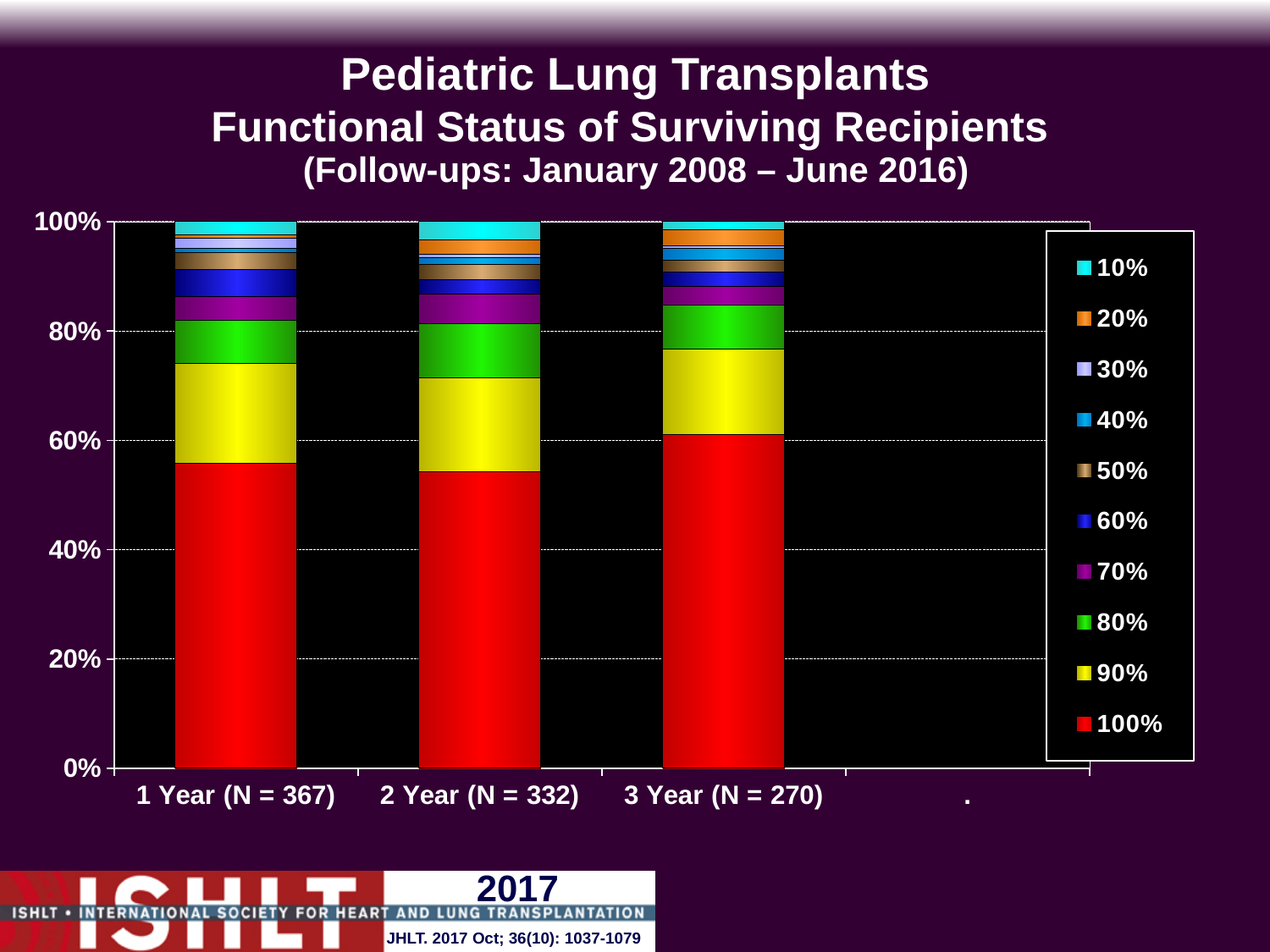
Which has the larger 100% functional status segment: 2 Year (N = 332) or 3 Year (N = 270)? 3 Year (N = 270) Is the 100% functional status segment for 3 Year (N = 270) greater or less than 40%? greater Is the 100% functional status segment for 2 Year (N = 332) greater or less than 40%? greater What follow-up period is given in the chart title? January 2008 – June 2016 What is the total height of each stacked bar according to the y axis? 100% How many follow-up time categories are plotted on the x axis? 3 What is the sample size (N) shown for the 1 Year category? 367 How many series does the legend list? 10 Which colour represents the 100% functional status series in the legend? Red Is the 100% functional status segment for 1 Year (N = 367) greater or less than 60%? less What kind of chart is shown on the slide? Stacked bar chart What is the sample size (N) shown for the 3 Year category? 270